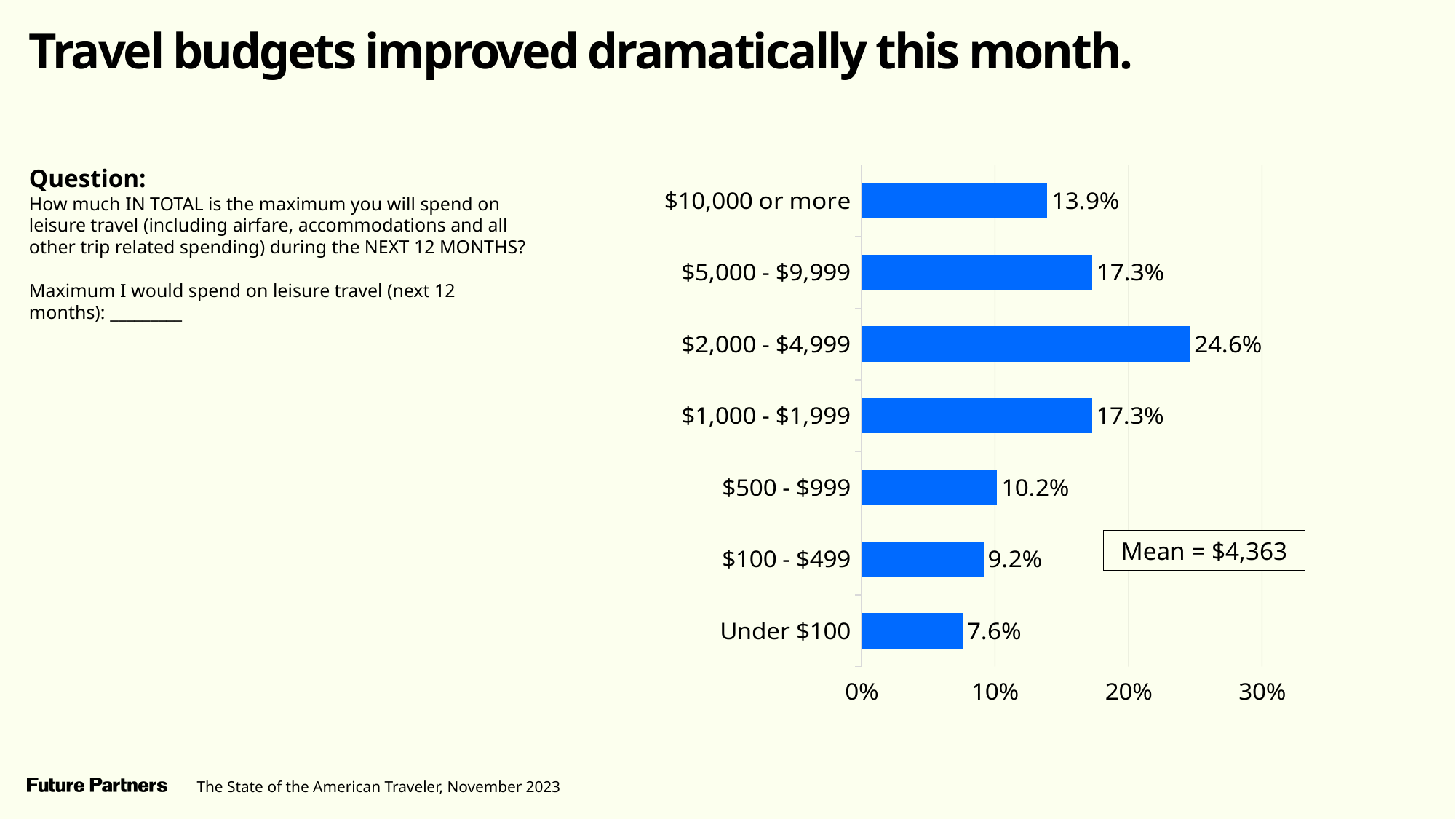
What percentage of respondents said their maximum leisure travel spend is $2,000 - $4,999? 24.6% Is the value for $1,000 - $1,999 greater or less than 20%? less What is the difference in percentage points between the $2,000 - $4,999 category and the $500 - $999 category? 14.4 What mean value is shown in the box on the chart? $4,363 What percentage of respondents said their maximum leisure travel spend is Under $100? 7.6% What percentage of respondents said their maximum leisure travel spend is $10,000 or more? 13.9% What kind of chart is shown on the slide? Bar chart How many spending categories are shown in the chart? 7 Which has a larger share of respondents: $10,000 or more, or $100 - $499? $10,000 or more Which spending category has the lowest percentage of respondents? Under $100 What is the combined percentage of respondents in the $5,000 - $9,999 and $10,000 or more categories? 31.2% Which spending category has the highest percentage of respondents? $2,000 - $4,999